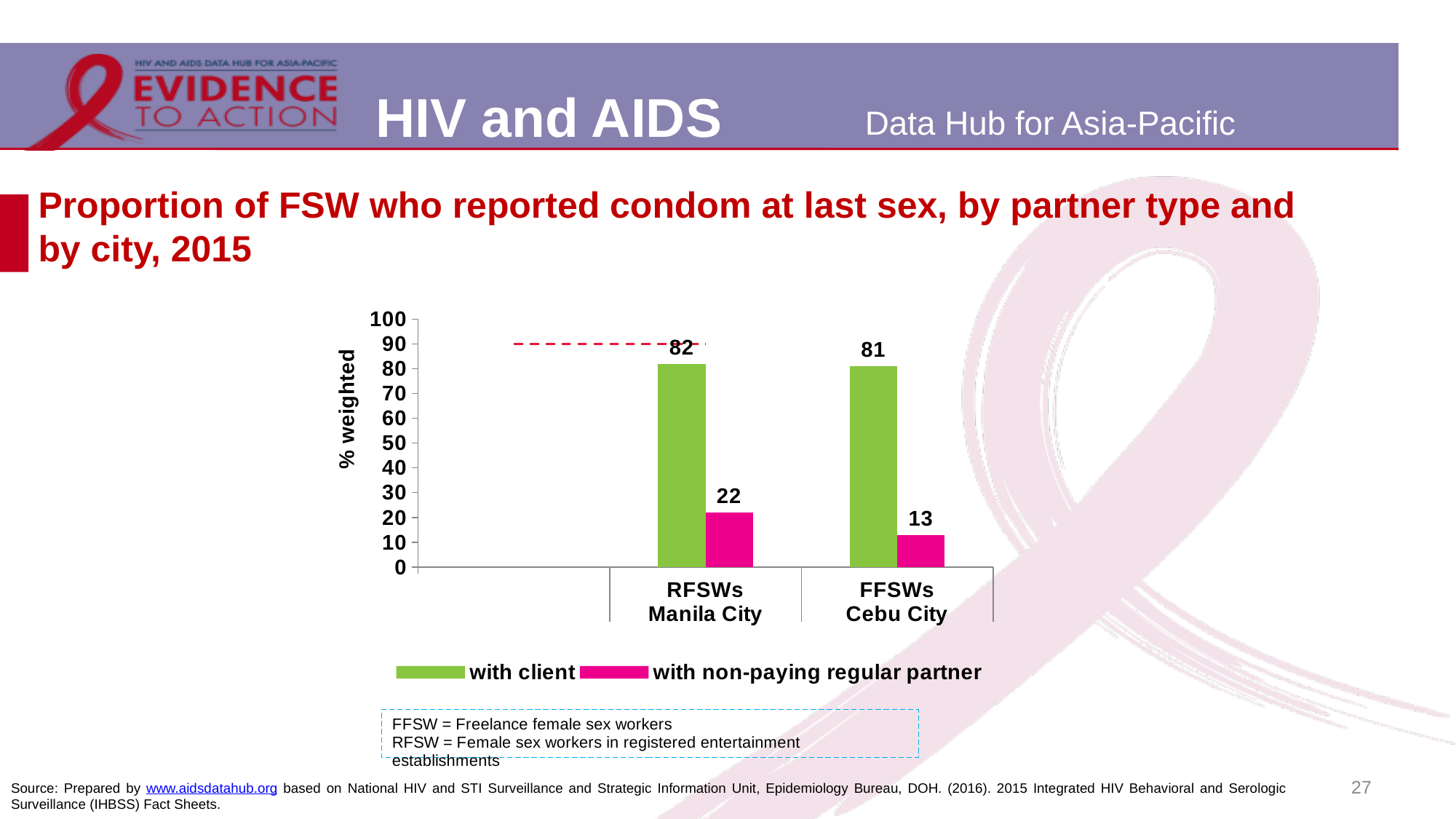
What is the label of the y axis? % weighted What is the value for 'with client' for FFSWs Cebu City? 81 Which is larger for FFSWs Cebu City: 'with client' or 'with non-paying regular partner'? with client How many categories are shown on the x axis? 2 What is the value for 'with non-paying regular partner' for FFSWs Cebu City? 13 What kind of chart is shown on the slide? bar chart How many series does the legend list? 2 What is the difference between the 'with client' and 'with non-paying regular partner' values for RFSWs Manila City? 60 What is the difference between the 'with non-paying regular partner' values for RFSWs Manila City and FFSWs Cebu City? 9 What is the value for 'with non-paying regular partner' for RFSWs Manila City? 22 Which category has the lowest value for 'with non-paying regular partner'? FFSWs Cebu City What is the value for 'with client' for RFSWs Manila City? 82